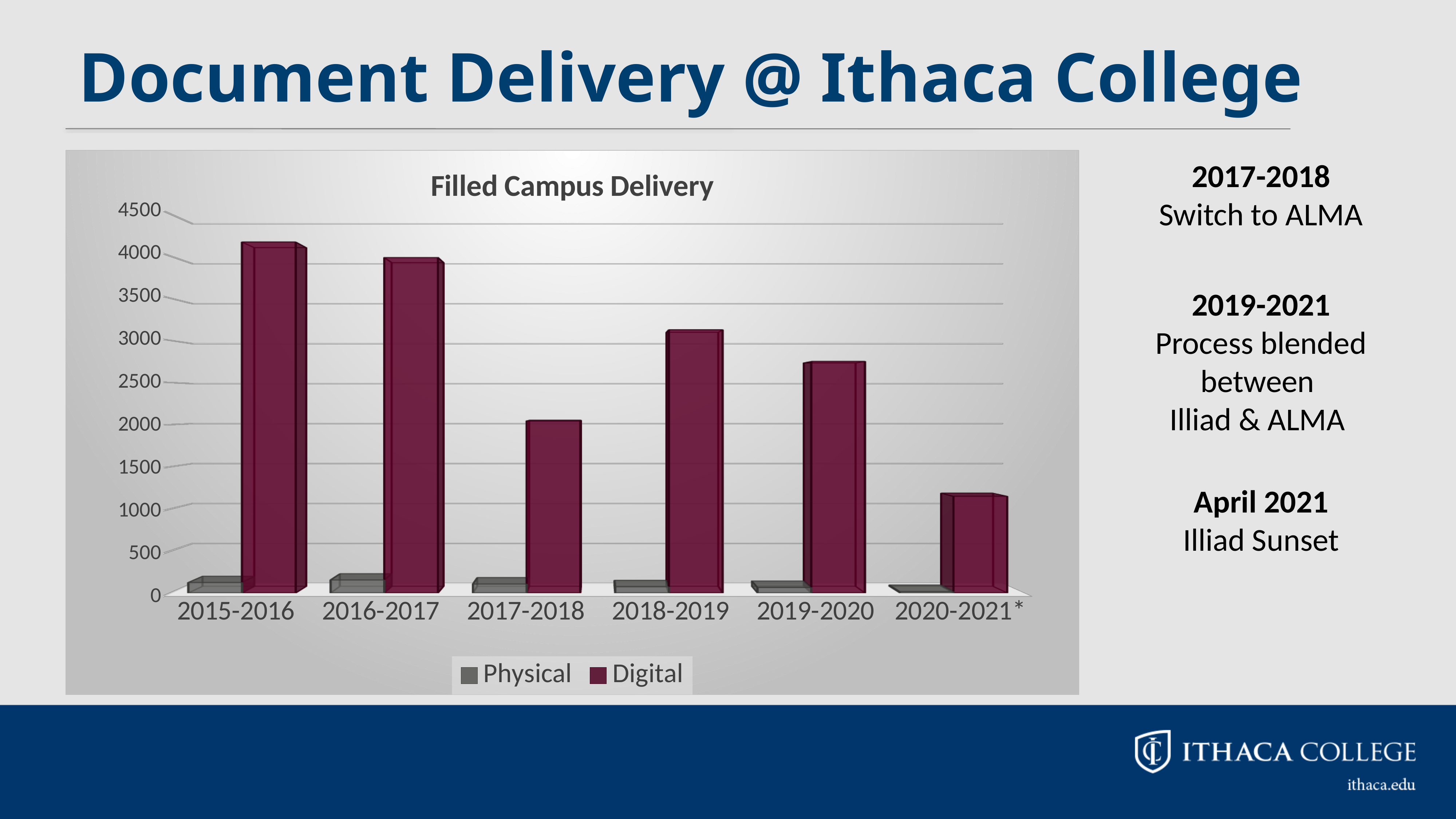
How many academic-year categories are shown on the x axis? 6 Which year has the lowest Digital value? 2020-2021* Which year has the highest Digital value? 2015-2016 Is the Digital value for 2020-2021* greater or less than 1500? less Is the Digital value for 2017-2018 greater or less than 2500? less What kind of chart is shown on the slide? bar chart Do the Digital values rise or fall from 2015-2016 to 2017-2018? fall Is the Digital value for 2016-2017 greater or less than 3500? greater What is the title of the chart? Filled Campus Delivery Which is larger, the Digital value for 2018-2019 or for 2019-2020? 2018-2019 How many series does the chart's legend list? 2